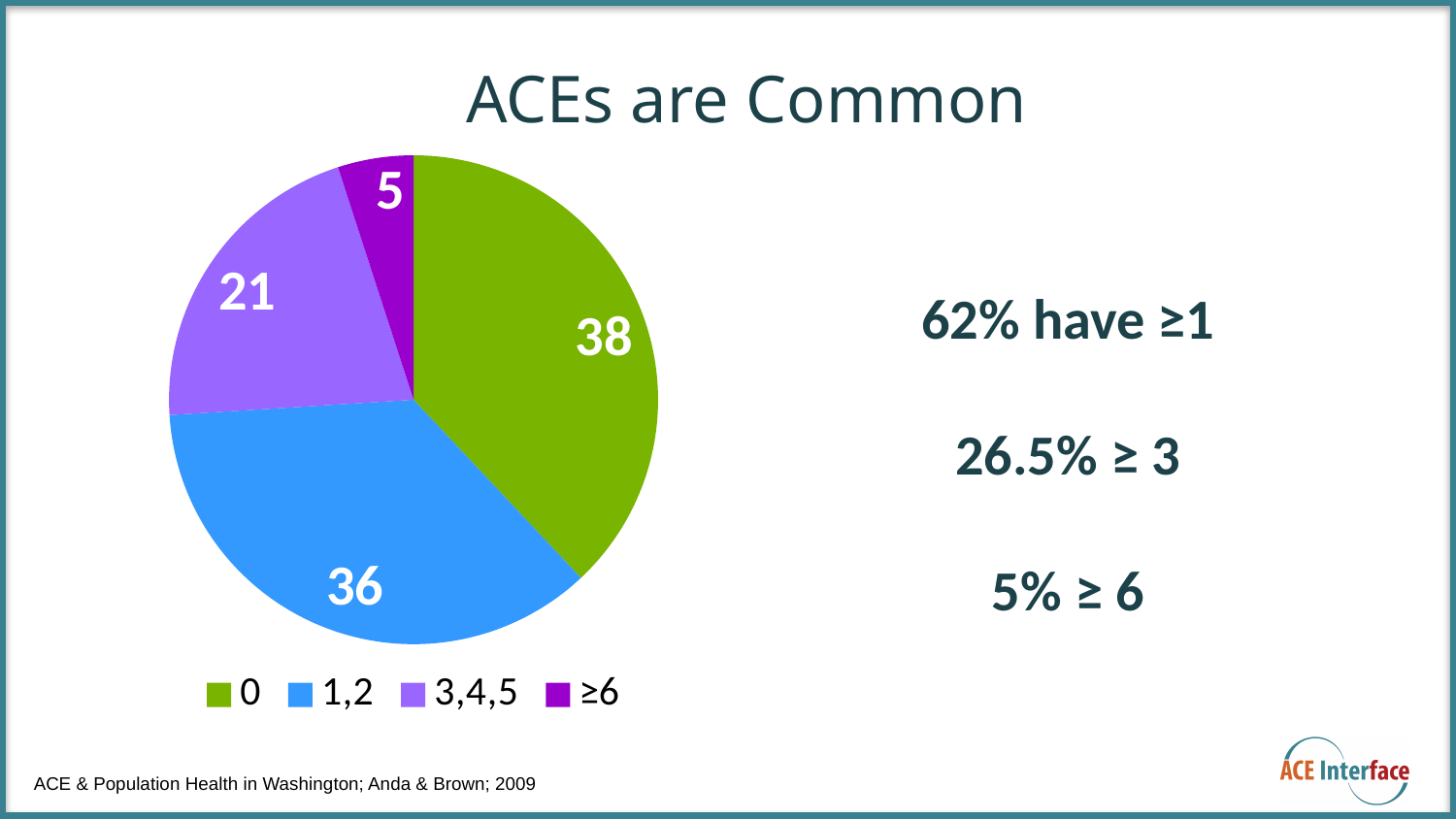
How many entries does the legend list? 4 What is the difference between the "3,4,5" slice and the "≥6" slice? 16 What is the value for the "3,4,5" slice? 21 Which category has the largest slice? 0 Which is larger, the "1,2" slice or the "3,4,5" slice? 1,2 What is the value for the "1,2" slice? 36 What is the value for the "0" slice? 38 Which category has the smallest slice? ≥6 How many slices does the pie chart have? 4 What kind of chart is shown on the slide? pie chart What is the value for the "≥6" slice? 5 What is the title of the slide containing the chart? ACEs are Common